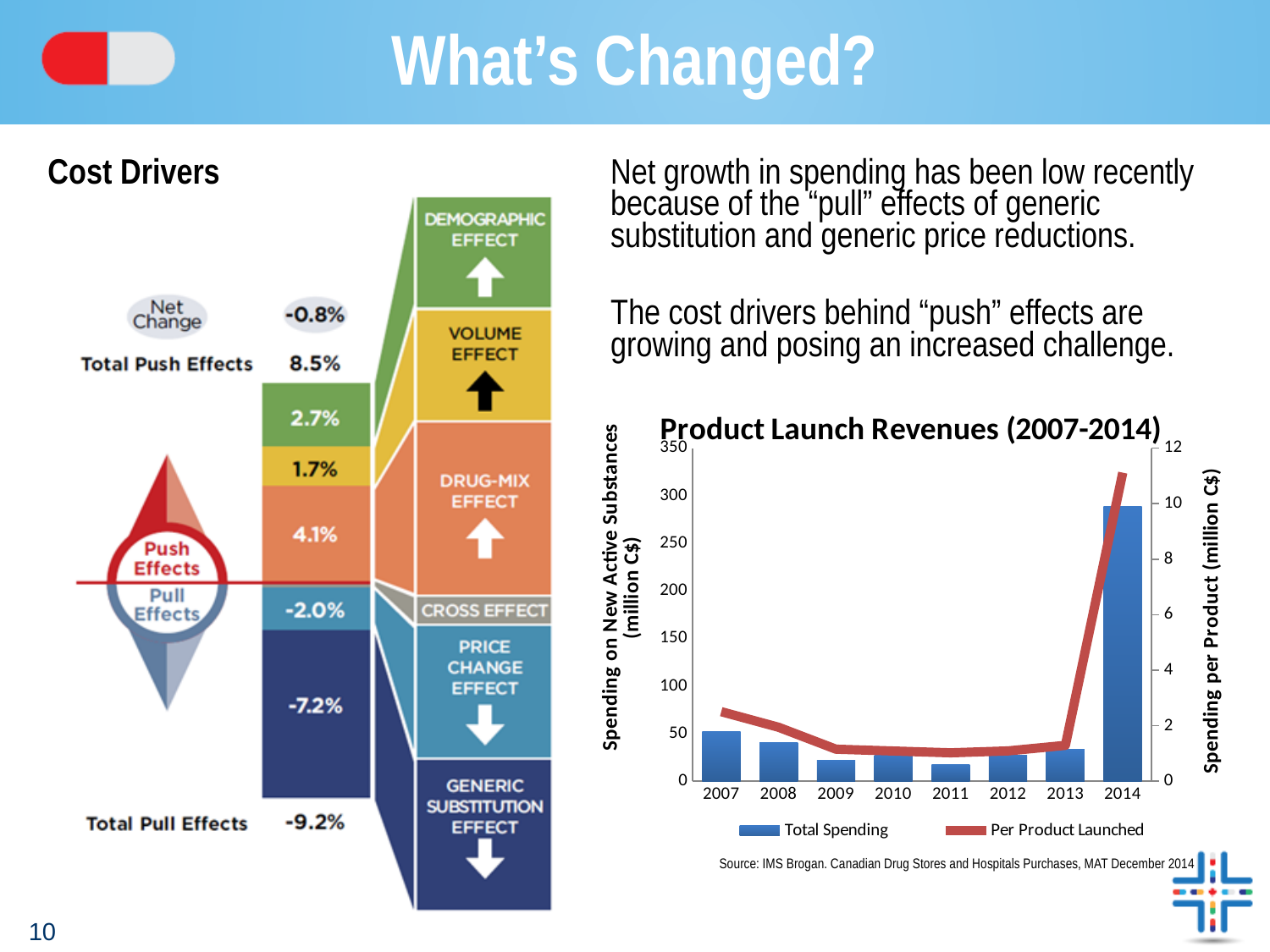
How many years are shown on the x axis of the Product Launch Revenues (2007-2014) chart? 8 In the Cost Drivers chart, what is the value of the Drug-Mix Effect? 4.1% In the Product Launch Revenues (2007-2014) chart, which year has the lowest Total Spending? 2011 How many series does the legend of the Product Launch Revenues (2007-2014) chart list? 2 In the Cost Drivers chart, what is the Net Change? -0.8% In the Product Launch Revenues (2007-2014) chart, is the Total Spending for 2014 greater or less than 250? greater In the Product Launch Revenues (2007-2014) chart, is the Total Spending for 2007 greater or less than 100? less In the Product Launch Revenues (2007-2014) chart, which year has the highest Total Spending? 2014 In the Cost Drivers chart, what is the value of the Generic Substitution Effect? -7.2% In the Cost Drivers chart, which is larger in magnitude, the Demographic Effect or the Volume Effect? Demographic Effect In the Cost Drivers chart, which push effect has the largest value? Drug-Mix Effect In the Cost Drivers chart, what are the Total Push Effects? 8.5%